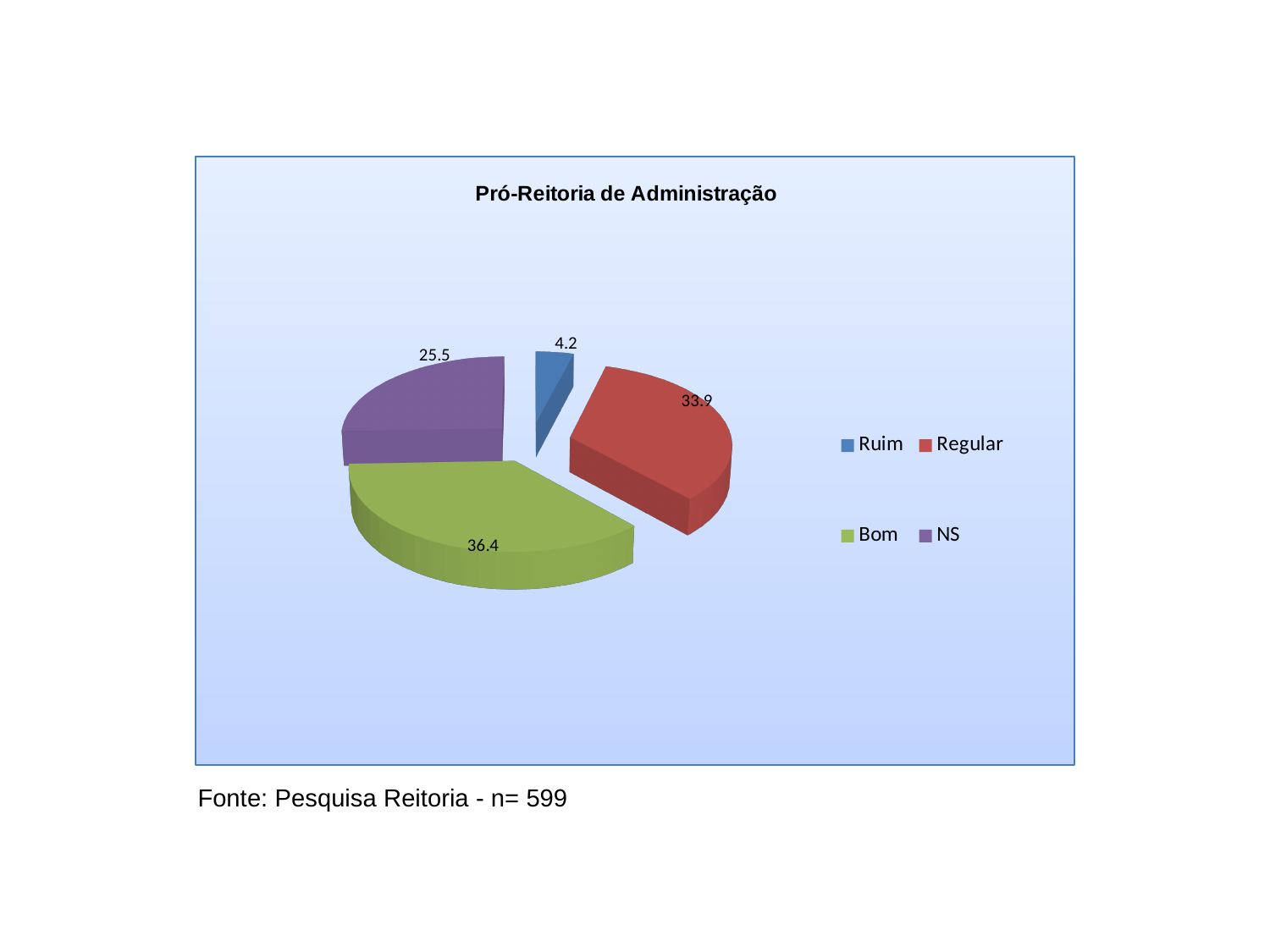
What is the difference between the values for NS and Ruim? 21.3 What is the difference between the values for Bom and Regular? 2.5 Which category has the largest slice? Bom Which category has the smallest slice? Ruim What is the value for Ruim? 4.2 Which is larger, the value for Regular or the value for NS? Regular How many categories does the pie chart show? 4 What kind of chart is shown on the slide? Pie chart What is the value for Bom? 36.4 What is the value for NS? 25.5 What is the title of the chart? Pró-Reitoria de Administração What is the value for Regular? 33.9